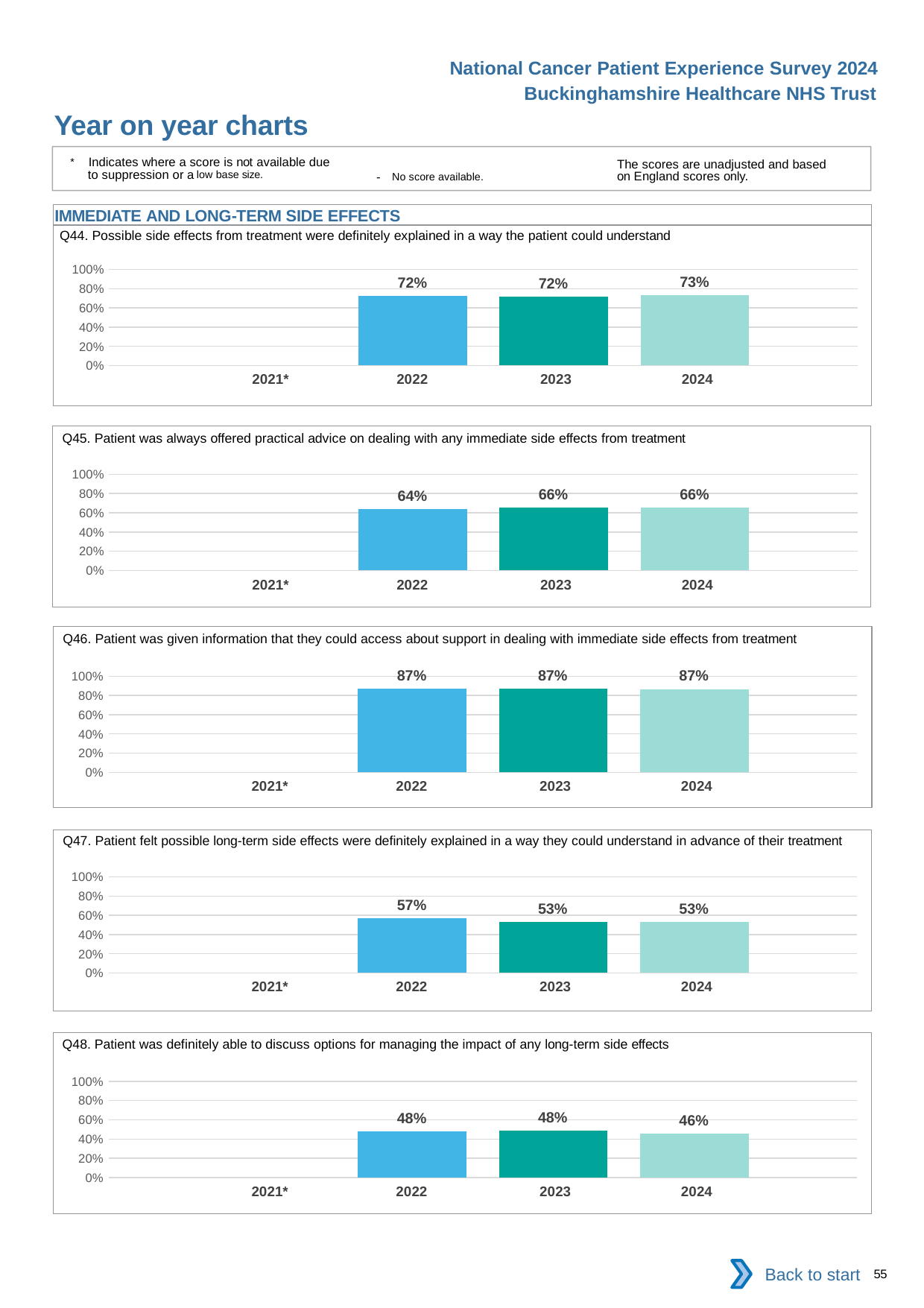
In the Q44 chart, what is the value for 2024? 73% How many year categories are shown on the x axis of the Q44 chart? 4 In the Q47 chart, is the value for 2024 greater or less than 60%? less In the Q48 chart, which year has the lowest value among those with a score? 2024 In the Q45 chart, what is the difference between the 2023 and 2022 values? 2% In the Q47 chart, do the values rise or fall from 2022 to 2024? fall In the Q46 chart, what is the value for 2023? 87% In the Q45 chart, what is the value for 2022? 64% In the Q47 chart, which year has the highest value? 2022 In the Q48 chart, is the value for 2023 greater or less than 40%? greater What kind of chart is the Q46 chart? bar chart In the Q47 chart, what is the difference between the 2022 and 2023 values? 4%